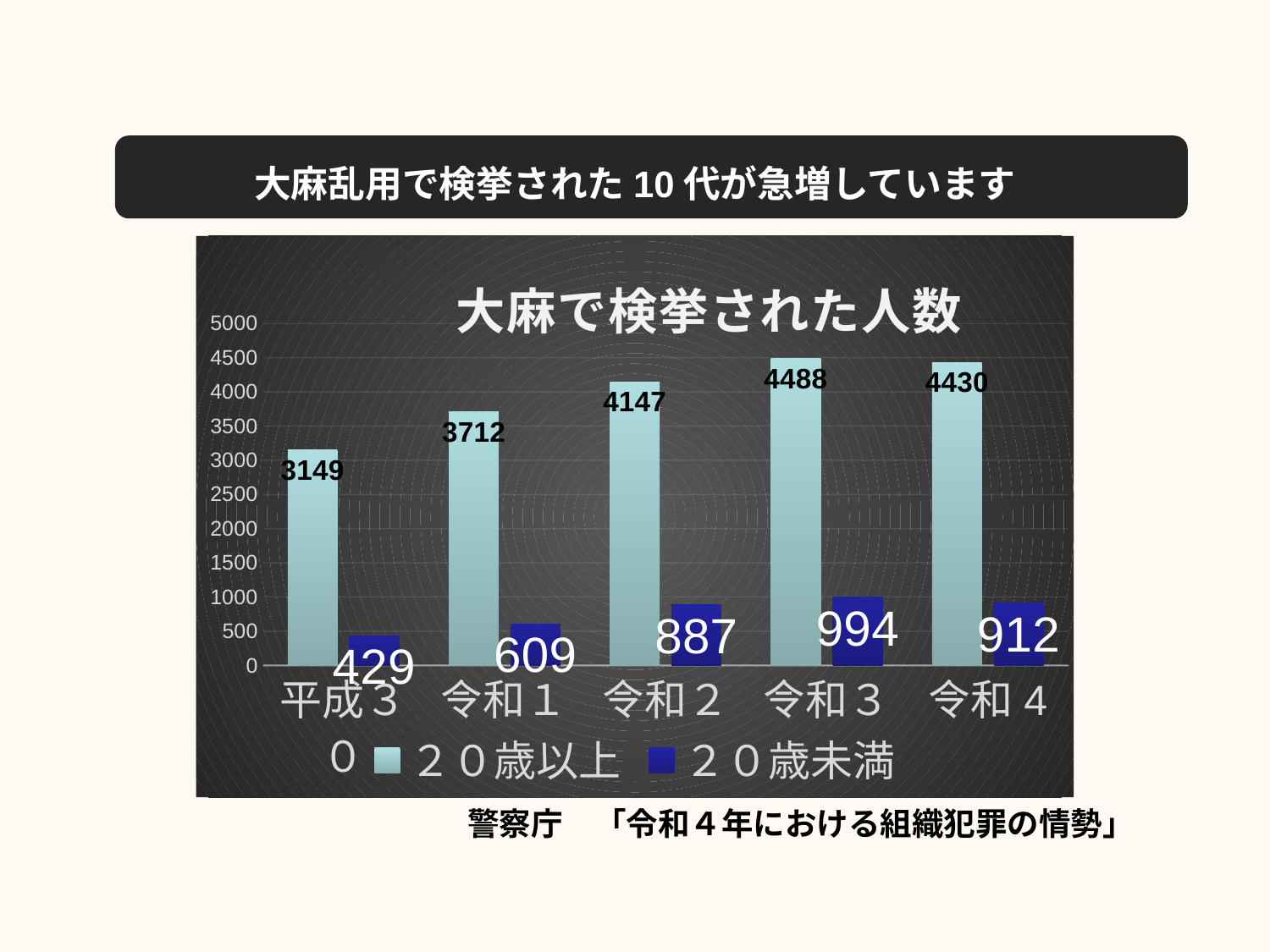
What is the difference between the 20歳以上 values for 令和3 and 令和4? 58 How many categories are shown on the x axis? 5 Which category has the highest value for 20歳未満? 令和3 Which is larger, the 20歳未満 value for 令和2 or for 令和4? 令和4 What kind of chart is this? bar chart Which category has the lowest value for 20歳以上? 平成3 What is the value for 20歳以上 in 令和3? 4488 What is the value for 20歳未満 in 平成3? 429 What is the title of the chart? 大麻で検挙された人数 What is the value for 20歳未満 in 令和4? 912 How many series does the legend list? 2 What is the difference between the 20歳未満 values for 令和2 and 平成3? 458